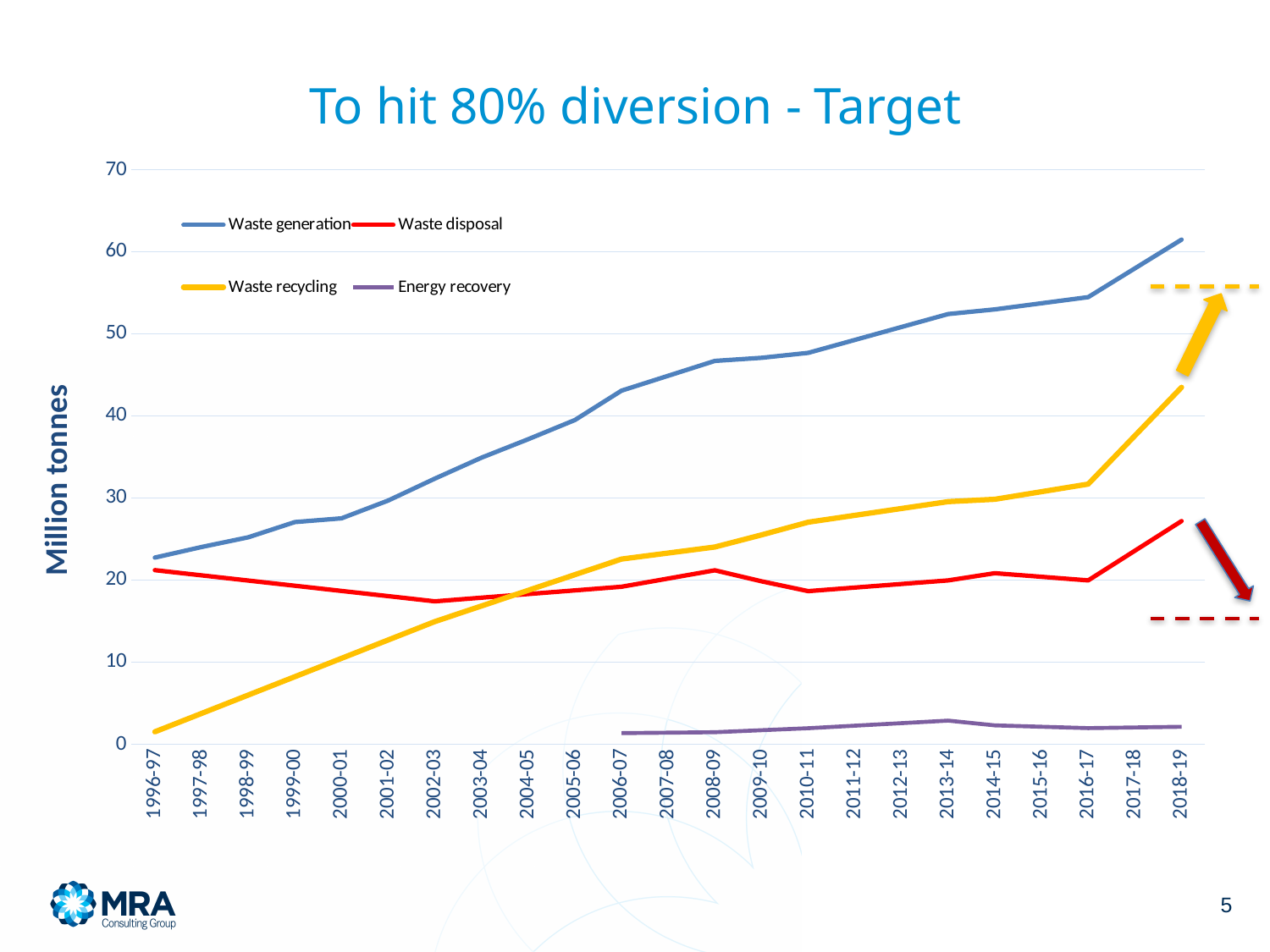
Which series is plotted with the yellow line? Waste recycling In 2018-19, which is larger: Waste recycling or Waste disposal? Waste recycling Is the value for Waste recycling in 1996-97 greater or less than 10? less Is the value for Waste recycling in 2018-19 greater or less than 40? greater Is the value for Waste disposal in 2002-03 greater or less than 20? less What kind of chart is shown on the slide? Line chart Which series has the highest value in 2018-19? Waste generation How many financial years are shown along the x axis? 23 Does the Waste generation line generally rise or fall from 1996-97 to 2018-19? Rise How many series does the chart legend list? 4 What is the label on the vertical axis? Million tonnes